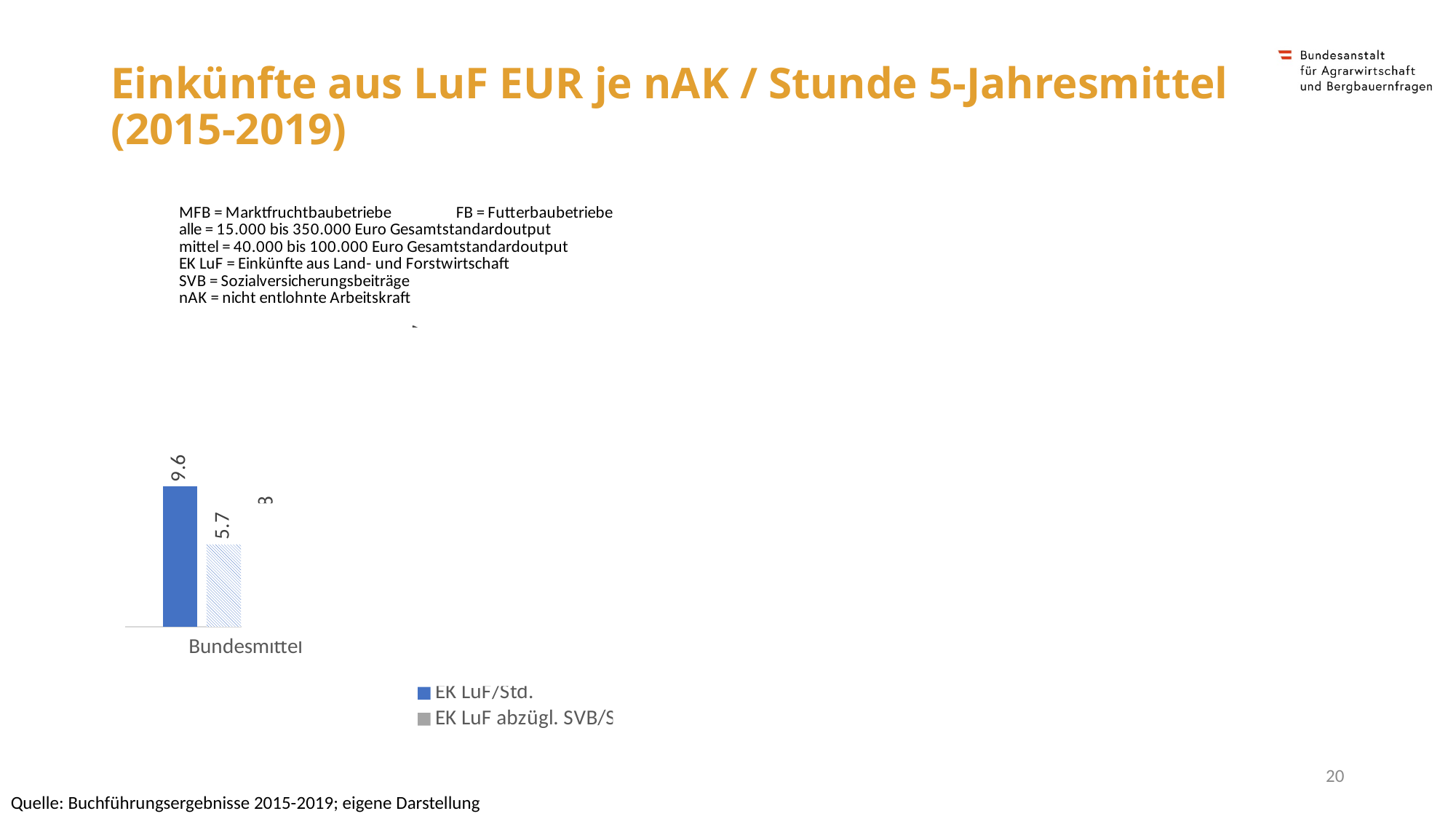
Which of the two bars for Bundesmittel is the highest? EK LuF/Std. (9.6) What is the difference between the EK LuF/Std. bar (9.6) and the hatched bar (5.7) for Bundesmittel? 3.9 What is the value of the EK LuF/Std. bar for Bundesmittel? 9.6 What kind of chart is shown on the slide? Bar chart For Bundesmittel, which bar is larger: EK LuF/Std. or the hatched EK LuF abzügl. SVB bar? EK LuF/Std. Which category label is shown on the x axis of the chart? Bundesmittel Which of the two bars for Bundesmittel is the lowest? The hatched bar (5.7) What is the value of the hatched (EK LuF abzügl. SVB) bar for Bundesmittel? 5.7 What is the first legend entry of the chart? EK LuF/Std.